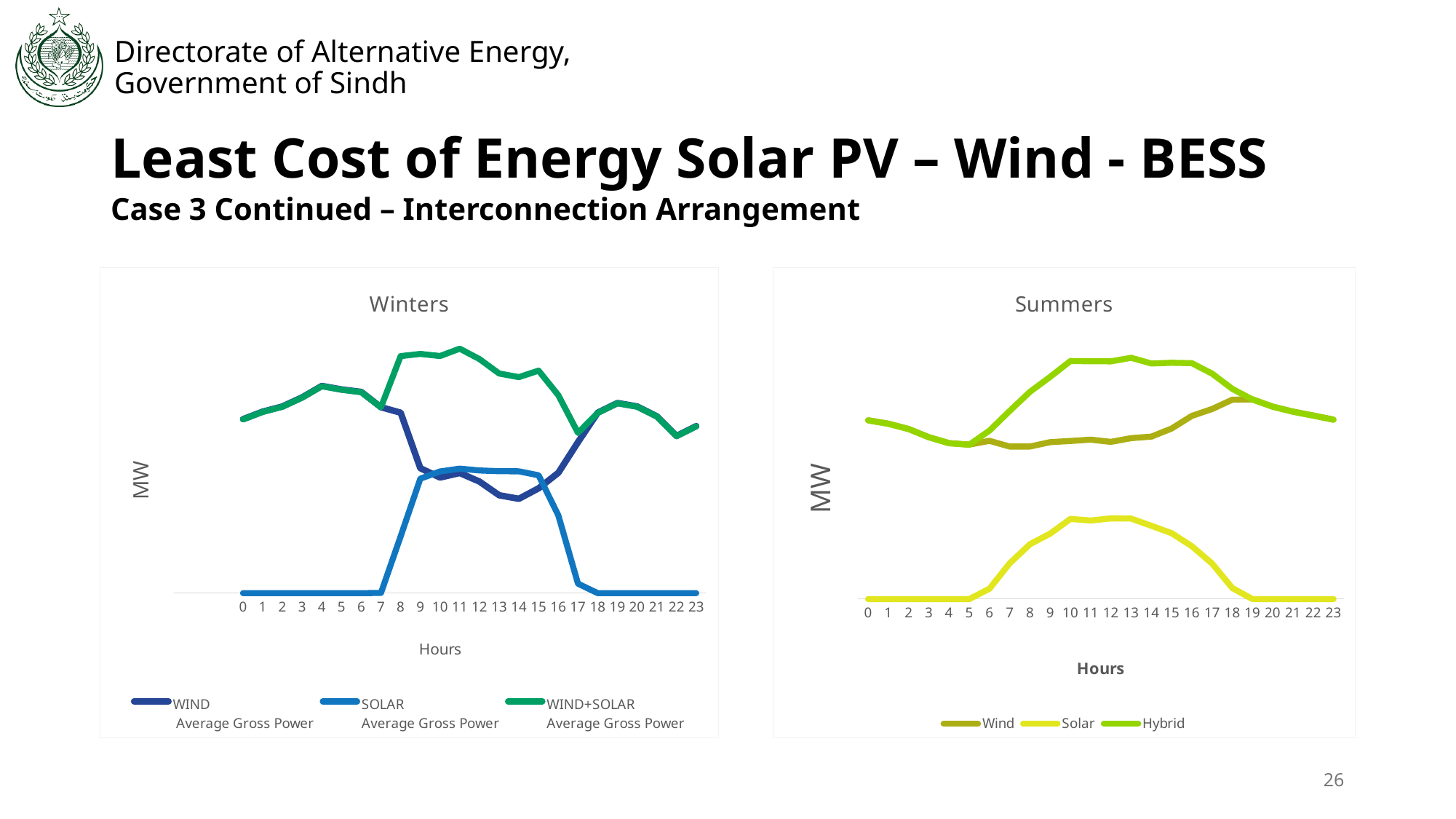
In the Winters chart, which series has the highest value at hour 11? WIND+SOLAR In the Summers chart, at hour 12, which is larger: Wind or Solar? Wind How many hour points are plotted along the x axis of the Summers chart? 24 In the Summers chart, does the Solar series rise or fall from hour 13 to hour 19? Fall In the Winters chart, at hour 4, which is larger: WIND or SOLAR? WIND In the Winters chart, at hour 14, which is larger: WIND or SOLAR? SOLAR What is the y-axis label on the Summers chart? MW In the Winters chart, does the WIND series rise or fall from hour 8 to hour 14? Fall How many series does the legend of the Summers chart list? 3 In the Summers chart, which series has the lowest value at hour 20? Solar How many series does the legend of the Winters chart list? 3 What kind of chart is the Winters chart? Line chart